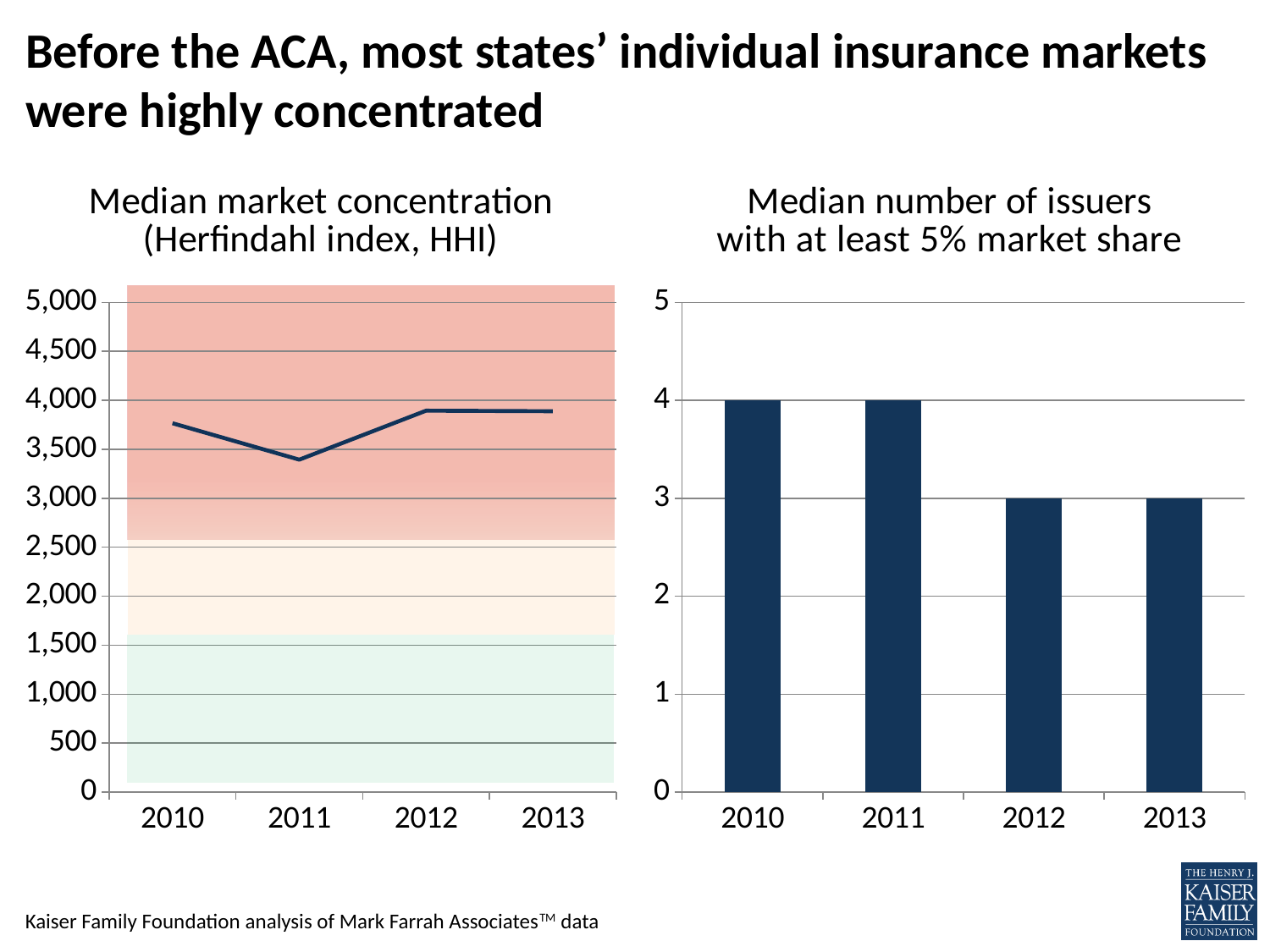
In the chart titled 'Median number of issuers with at least 5% market share', what is the value for 2013? 3 In the chart titled 'Median market concentration (Herfindahl index, HHI)', which year has the larger value, 2010 or 2011? 2010 In the chart titled 'Median market concentration (Herfindahl index, HHI)', is the value for 2011 greater or less than 3,500? less In the chart titled 'Median number of issuers with at least 5% market share', what is the difference between the values for 2011 and 2012? 1 In the chart titled 'Median market concentration (Herfindahl index, HHI)', how many data points are plotted on the line? 4 What kind of chart is the one on the left of the slide, titled 'Median market concentration (Herfindahl index, HHI)'? line chart In the chart titled 'Median market concentration (Herfindahl index, HHI)', which year has the lowest value? 2011 In the chart titled 'Median number of issuers with at least 5% market share', what is the value for 2010? 4 In the chart titled 'Median number of issuers with at least 5% market share', how many years are shown on the x axis? 4 What kind of chart is the one on the right of the slide, titled 'Median number of issuers with at least 5% market share'? bar chart In the chart titled 'Median number of issuers with at least 5% market share', do the values rise or fall from 2010 to 2013? fall In the chart titled 'Median market concentration (Herfindahl index, HHI)', is the value for 2012 greater or less than 3,500? greater